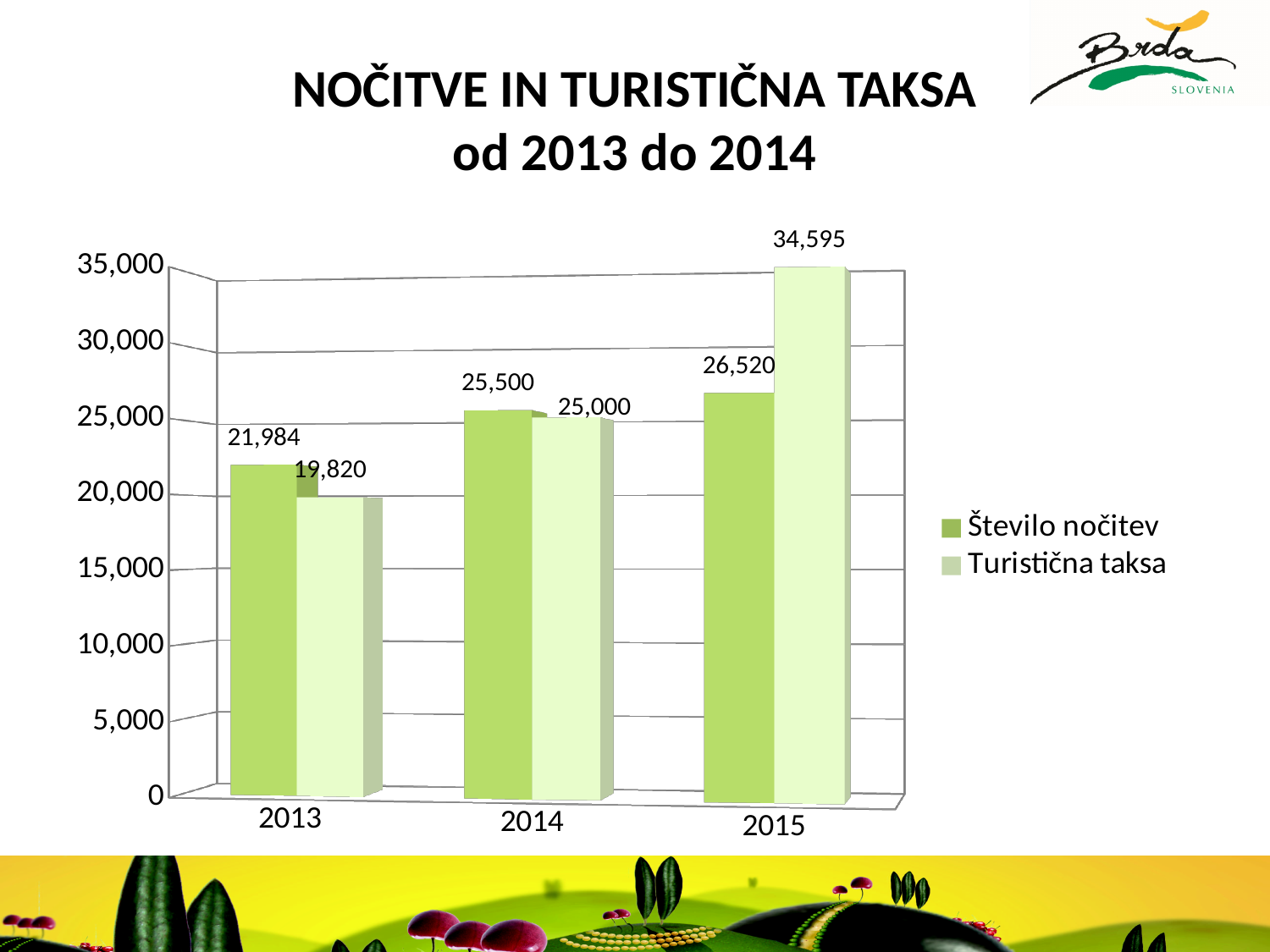
Does Število nočitev rise or fall from 2013 to 2015? Rise What kind of chart is shown on the slide? Bar chart What is the value of Število nočitev for 2015? 26,520 What is the value of Turistična taksa for 2015? 34,595 How many series does the legend list? 2 What is the difference between Turistična taksa in 2015 and in 2014? 9,595 What is the value of Število nočitev for 2013? 21,984 What is the value of Turistična taksa for 2014? 25,000 In which year is Turistična taksa highest? 2015 How many years are shown on the x axis? 3 Which is larger in 2013: Število nočitev or Turistična taksa? Število nočitev In which year is Število nočitev lowest? 2013